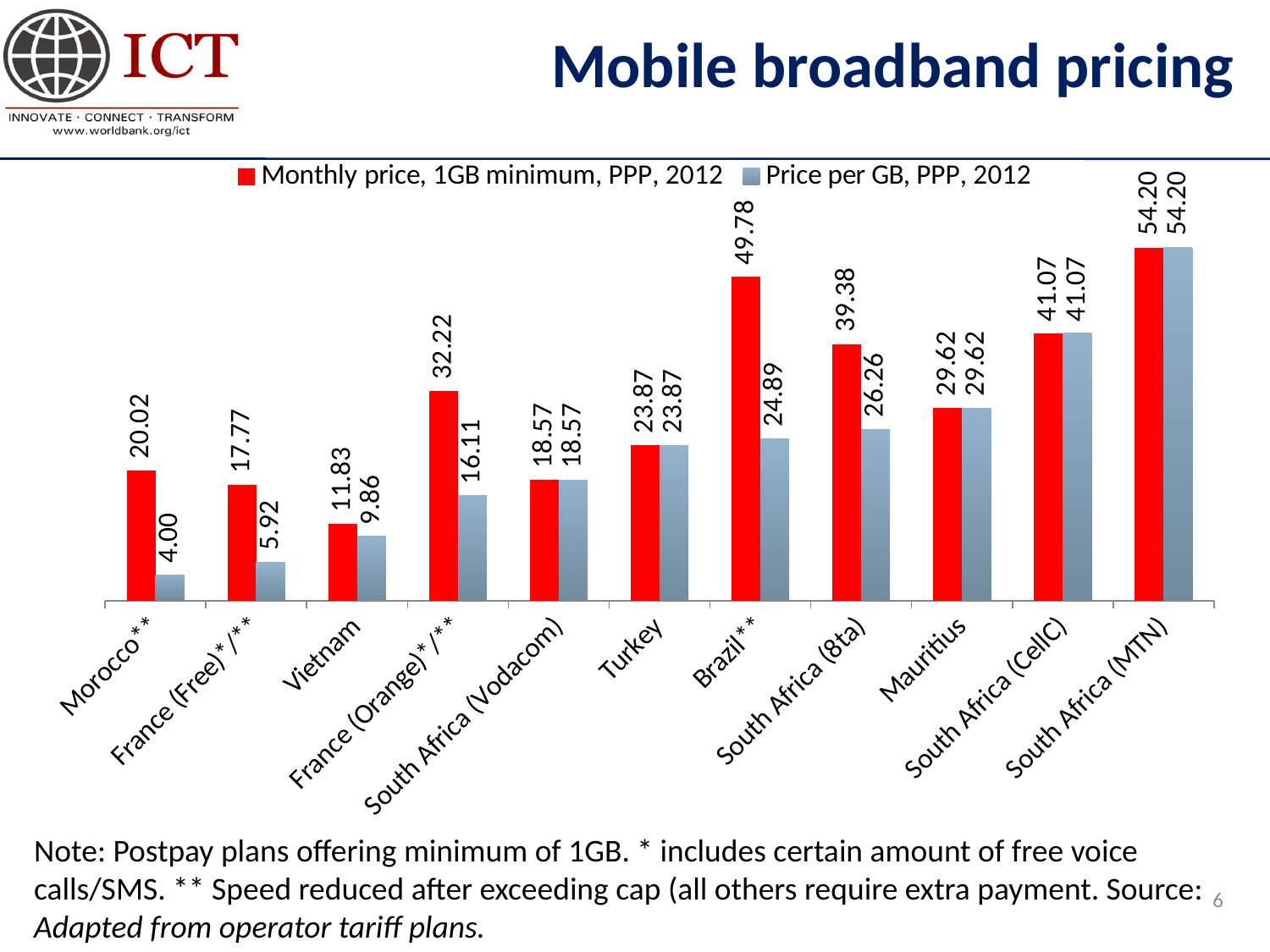
Which category has the lowest monthly price, 1GB minimum, PPP, 2012? Vietnam How many categories are shown on the x axis of the chart? 11 What is the difference in monthly price, 1GB minimum, PPP, 2012 between South Africa (MTN) and South Africa (CellC)? 13.13 What is the monthly price, 1GB minimum, PPP, 2012 for Brazil**? 49.78 What is the price per GB, PPP, 2012 for Morocco**? 4.00 What is the price per GB, PPP, 2012 for France (Orange)*/**? 16.11 Which category has the lowest price per GB, PPP, 2012? Morocco** Which has a higher price per GB, PPP, 2012: Turkey or South Africa (8ta)? South Africa (8ta) What is the difference between the monthly price and the price per GB for Brazil**? 24.89 Which category has the highest monthly price, 1GB minimum, PPP, 2012? South Africa (MTN) What kind of chart is shown on the slide? Bar chart How many series does the legend list? 2